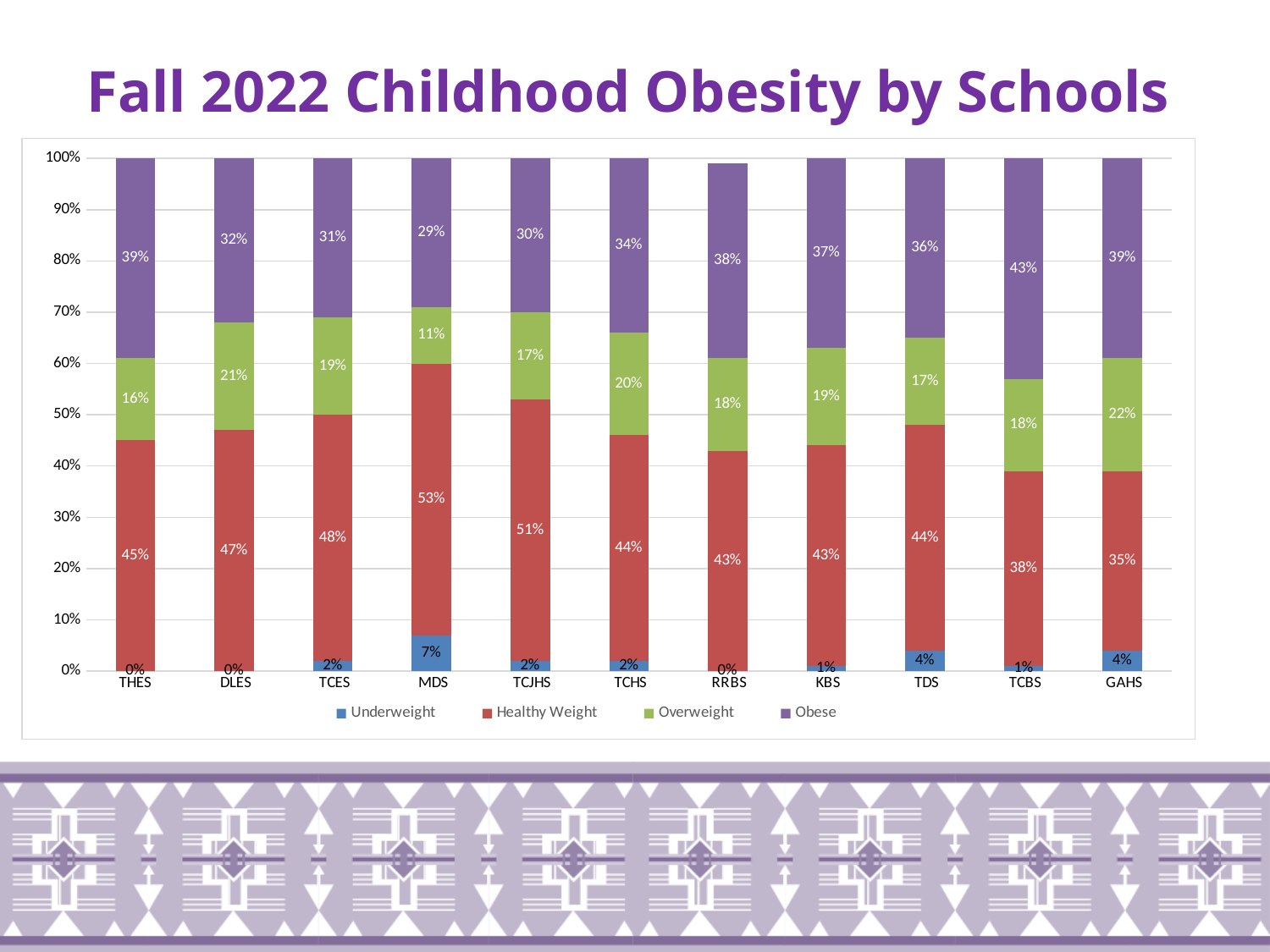
Which school has the lowest Overweight percentage? MDS What is the Healthy Weight percentage for MDS? 53% Which school has the highest Obese percentage? TCBS What is the Obese percentage for TCBS? 43% Which school has the lowest Healthy Weight percentage? GAHS What kind of chart is shown on the slide? stacked bar chart What is the difference between the Obese percentage for TCBS and the Obese percentage for MDS? 14 percentage points How many schools are shown on the x axis? 11 How many series does the legend list? 4 What is the Underweight percentage for TDS? 4% Which is larger, the Overweight percentage for DLES or the Overweight percentage for THES? DLES What is the title of the chart? Fall 2022 Childhood Obesity by Schools